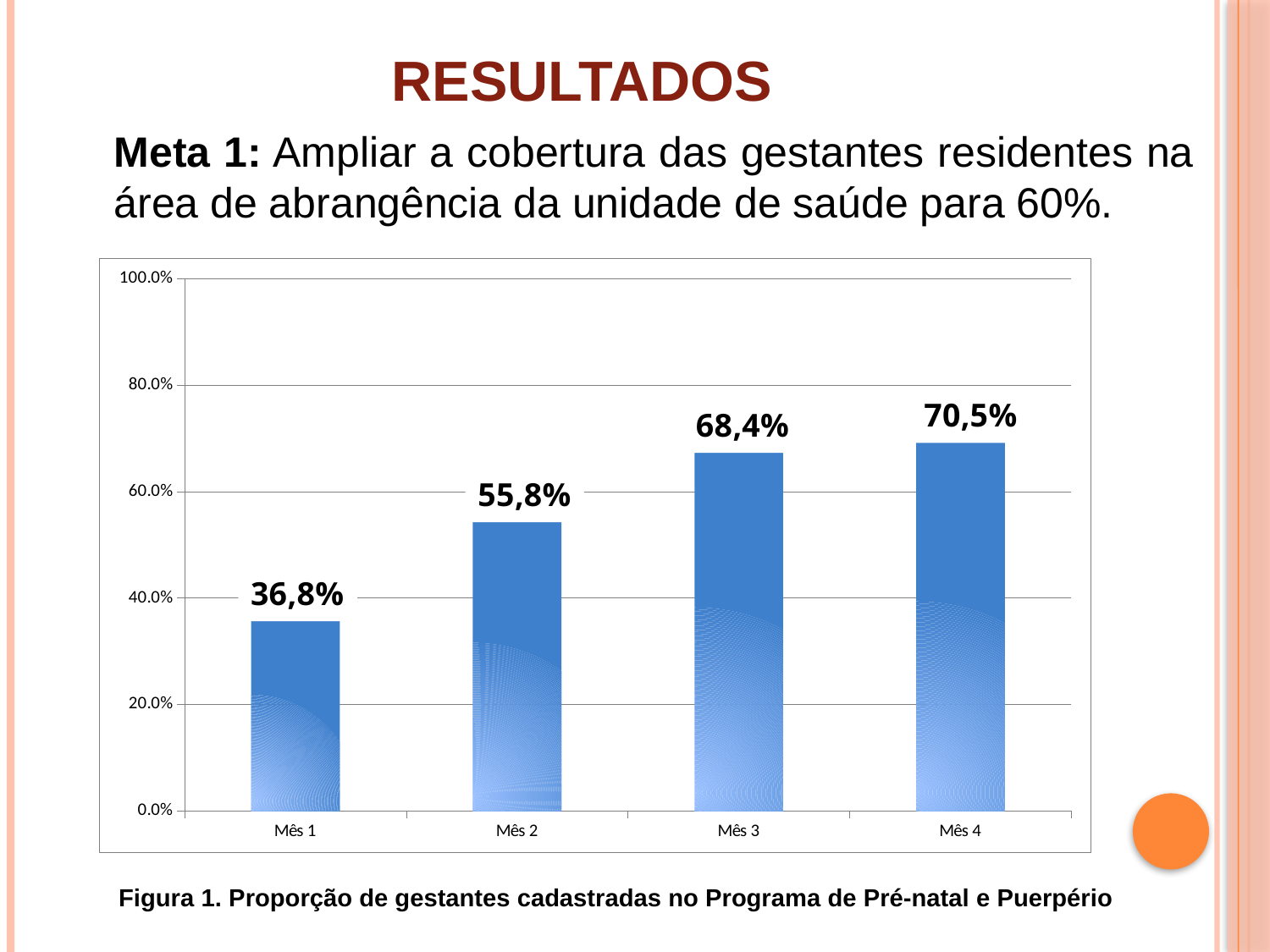
Which month has the lowest value? Mês 1 What is the difference between the values for Mês 4 and Mês 1? 33,7 percentage points Is the value for Mês 2 greater or less than 60.0%? less What kind of chart is shown on the slide? Bar chart Do the values rise or fall from Mês 1 to Mês 4? Rise What is the value for Mês 1? 36,8% What is the difference between the values for Mês 3 and Mês 2? 12,6 percentage points What is the value for Mês 4? 70,5% What is the value for Mês 3? 68,4% Which month has the highest value? Mês 4 Which is larger, the value for Mês 2 or the value for Mês 3? Mês 3 How many months are shown on the x axis? 4